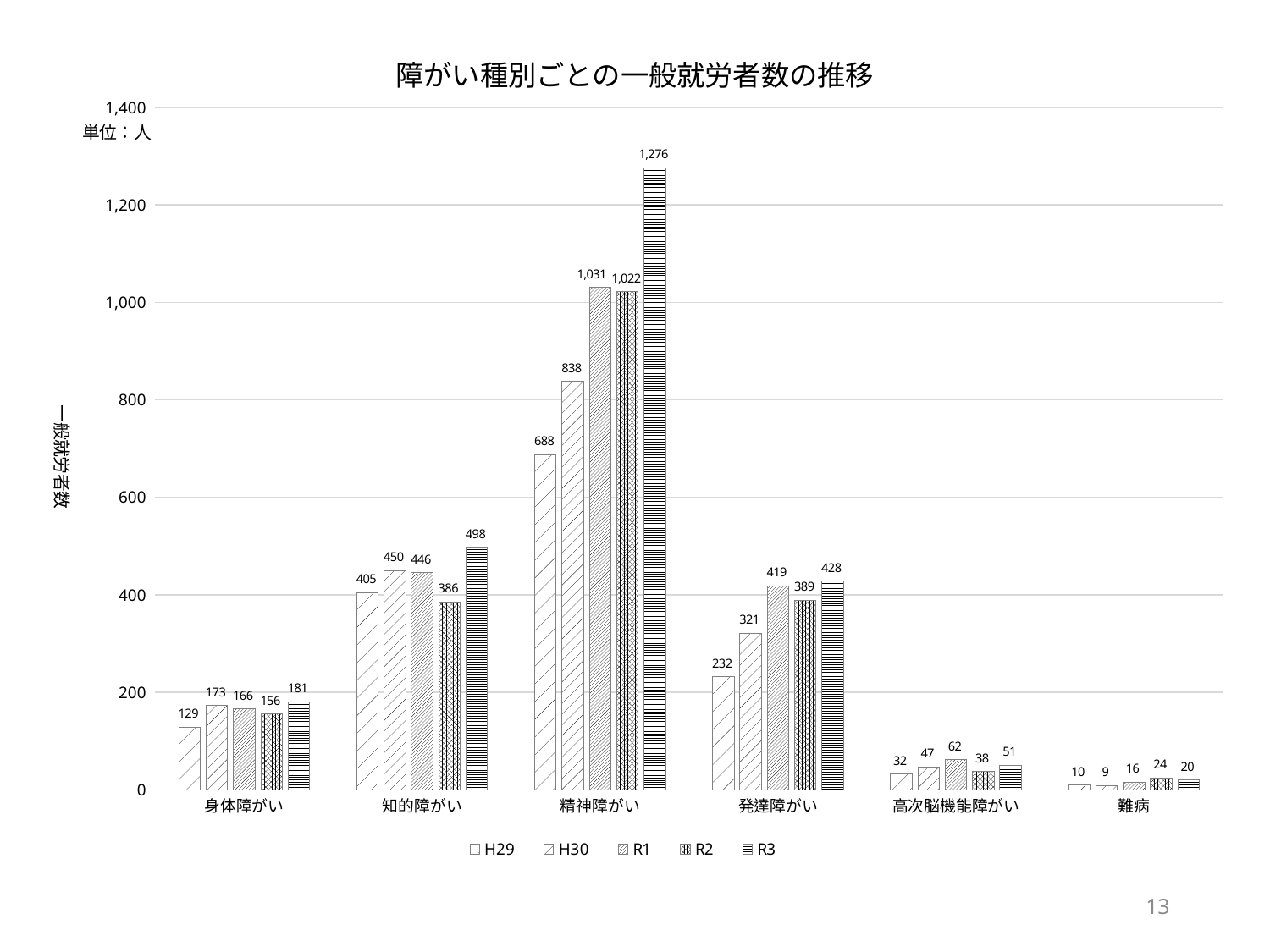
Which is larger for 発達障がい: the R1 value or the R2 value? R1 How many series does the legend list? 5 What is the title of the chart? 障がい種別ごとの一般就労者数の推移 Which category has the highest value in R3? 精神障がい How many categories are shown on the x axis? 6 Which category has the lowest value in H30? 難病 What is the value for 知的障がい in H29? 405 What kind of chart is shown on the slide? bar chart Do the values for 高次脳機能障がい rise or fall from R1 to R2? fall What is the value for 難病 in R2? 24 What is the difference between the R3 and H29 values for 精神障がい? 588 What is the value for 精神障がい in R3? 1,276